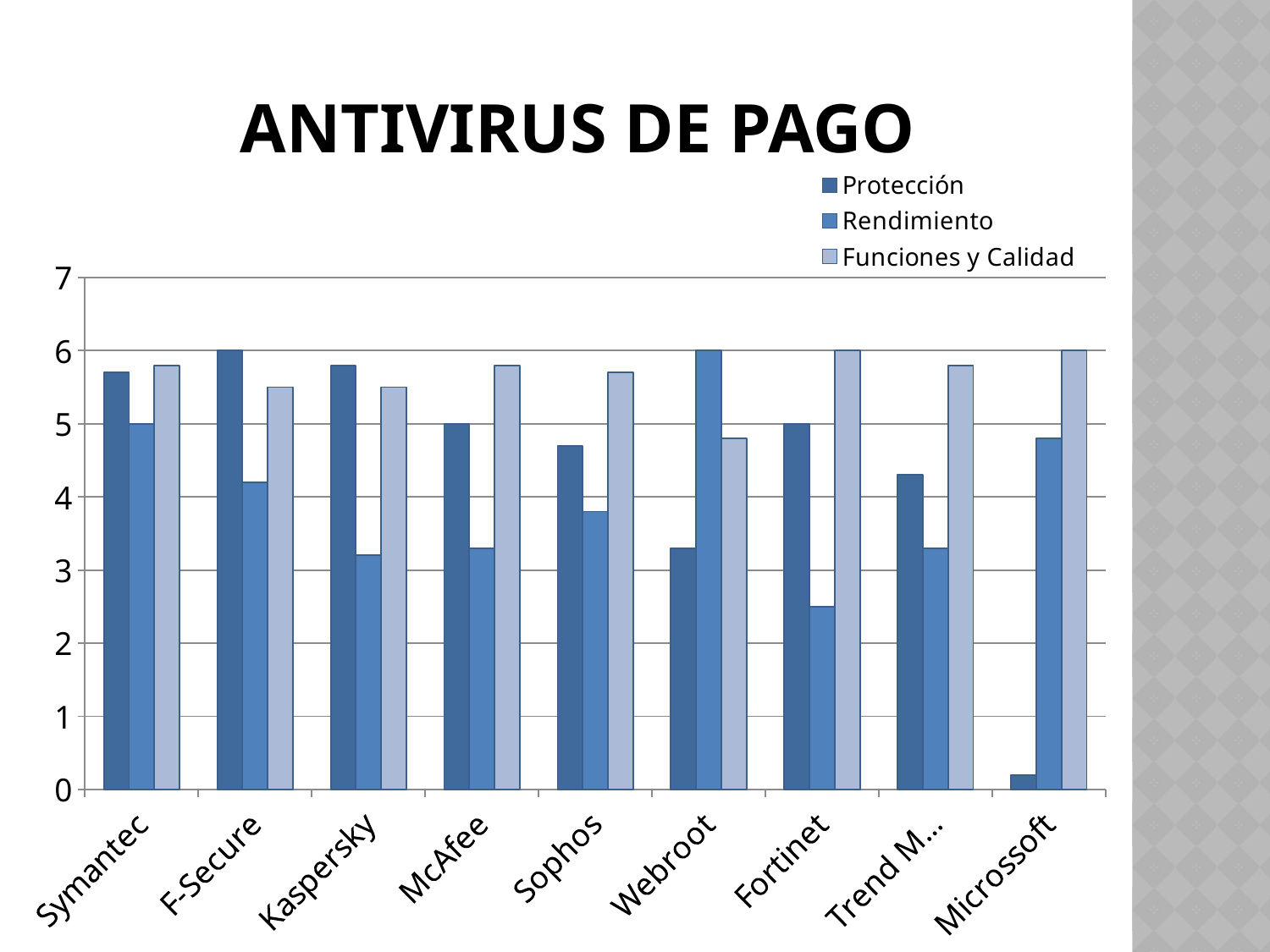
How many series does the legend list? 3 What is the Protección value for F-Secure? 6 Is the Rendimiento value for Fortinet greater or less than 3? less For Webroot, which is larger: Protección or Rendimiento? Rendimiento Which antivirus has the highest Rendimiento value? Webroot What kind of chart is shown on the slide? bar chart Which antivirus has the lowest Protección value? Microssoft Is the Funciones y Calidad value for Sophos greater or less than 5? greater What are the three series named in the legend? Protección, Rendimiento, Funciones y Calidad Is the Protección value for Microsoft greater or less than 1? less How many antivirus products (categories) are shown on the x axis? 9